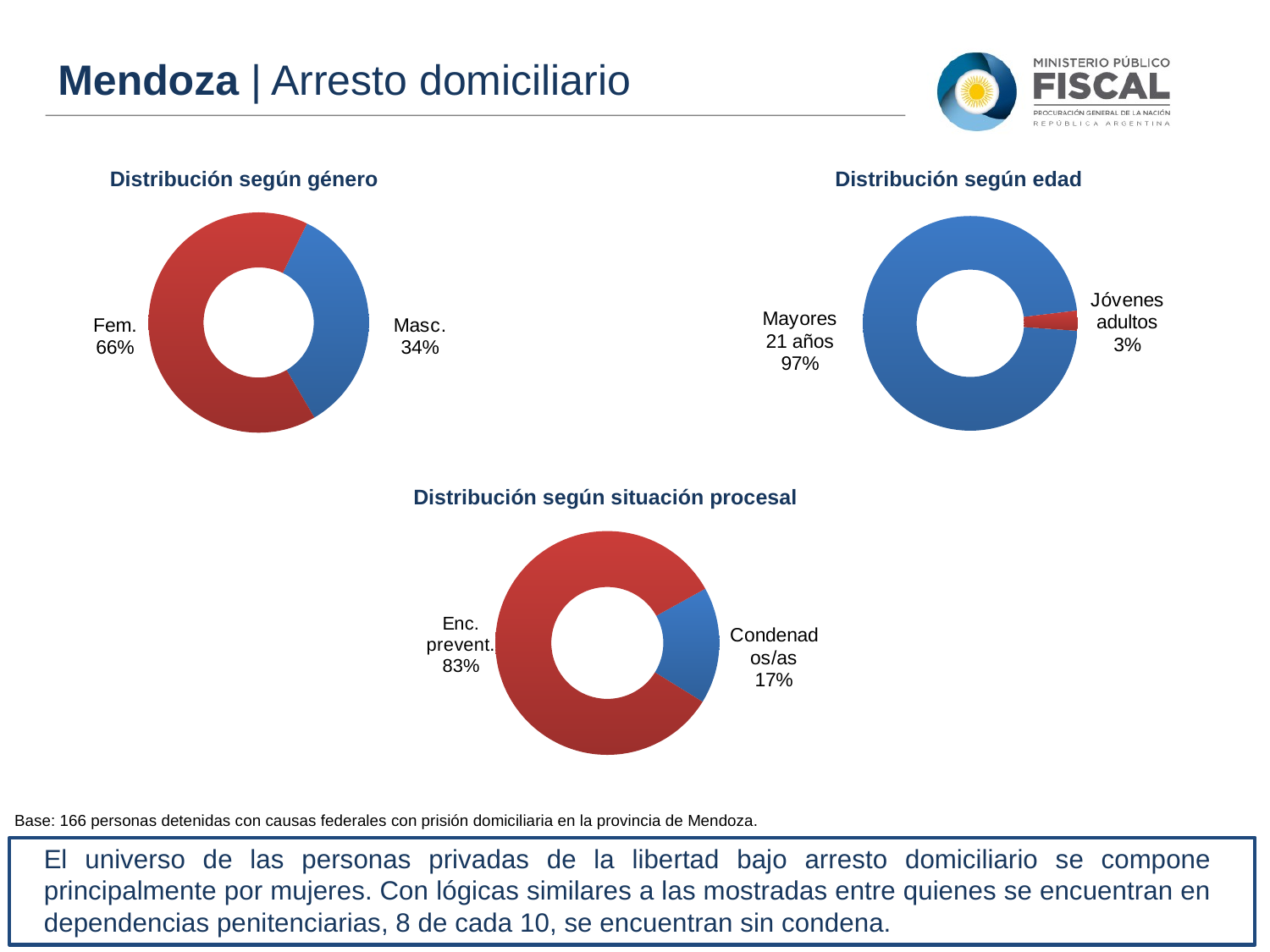
What kind of chart is 'Distribución según situación procesal'? Pie chart (donut) In the 'Distribución según género' chart, what share is labelled for Fem.? 66% In the 'Distribución según situación procesal' chart, what share is labelled for Condenados/as? 17% How many charts are shown on the slide? 3 In the 'Distribución según género' chart, what share is labelled for Masc.? 34% In the 'Distribución según edad' chart, what share is labelled for Jóvenes adultos? 3% In the 'Distribución según situación procesal' chart, what is the difference in percentage points between Enc. prevent. and Condenados/as? 66 In the 'Distribución según situación procesal' chart, what share is labelled for Enc. prevent.? 83% In the 'Distribución según género' chart, which is larger, Fem. or Masc.? Fem. In the 'Distribución según género' chart, which category has the largest share? Fem. In the 'Distribución según edad' chart, what share is labelled for Mayores 21 años? 97% In the 'Distribución según edad' chart, which category has the smallest share? Jóvenes adultos